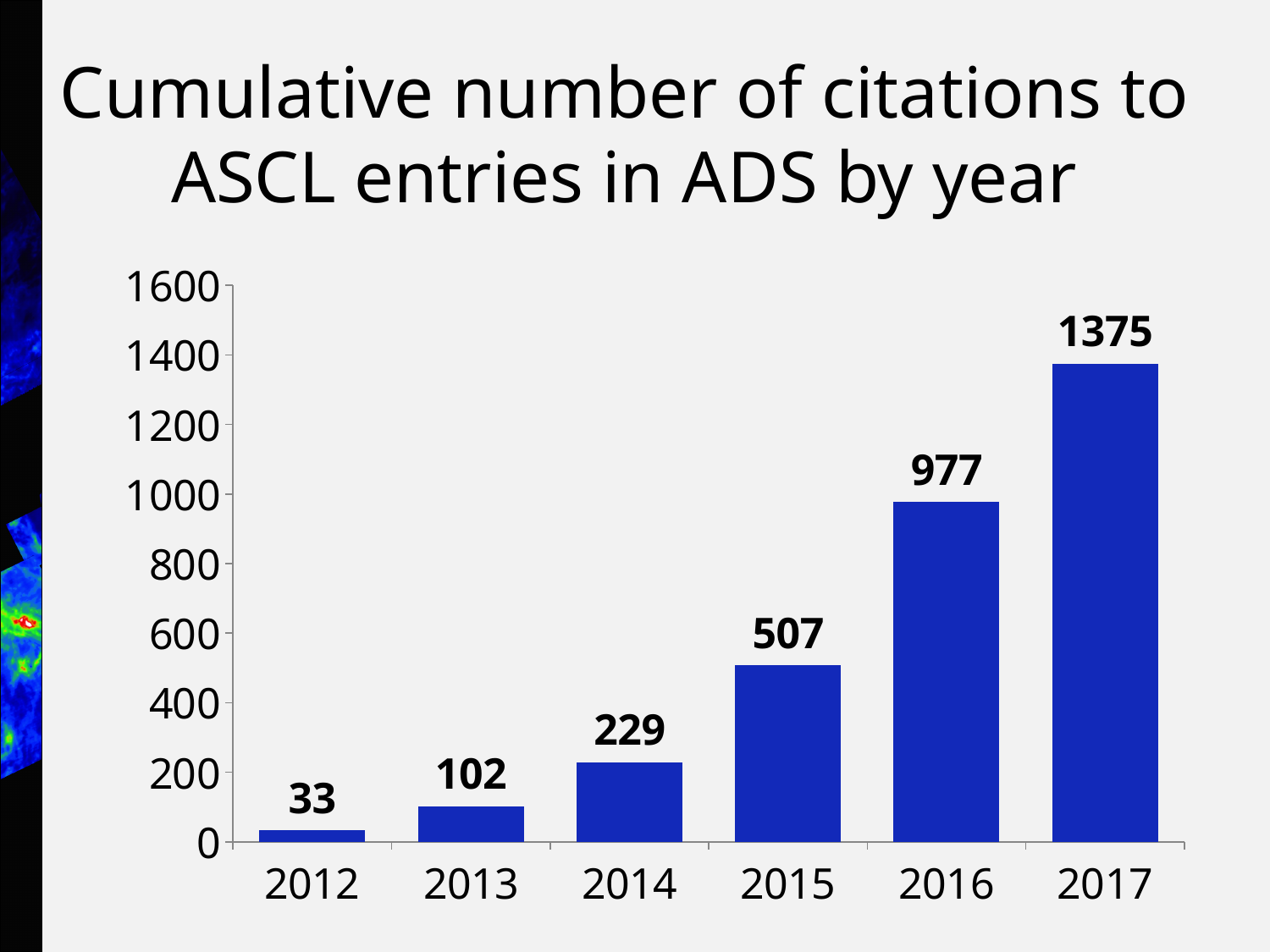
What is the difference between the values for 2014 and 2013? 127 What is the cumulative number of citations for 2012? 33 Is the value for 2016 greater or less than 800? greater Which year has the highest cumulative number of citations? 2017 Which is larger, the value for 2015 or the value for 2016? 2016 What is the cumulative number of citations for 2015? 507 What is the difference between the values for 2017 and 2016? 398 What kind of chart is shown on the slide? bar chart What is the cumulative number of citations for 2017? 1375 Which year has the lowest cumulative number of citations? 2012 How many years are shown on the x axis? 6 Do the values rise or fall from 2012 to 2017? rise